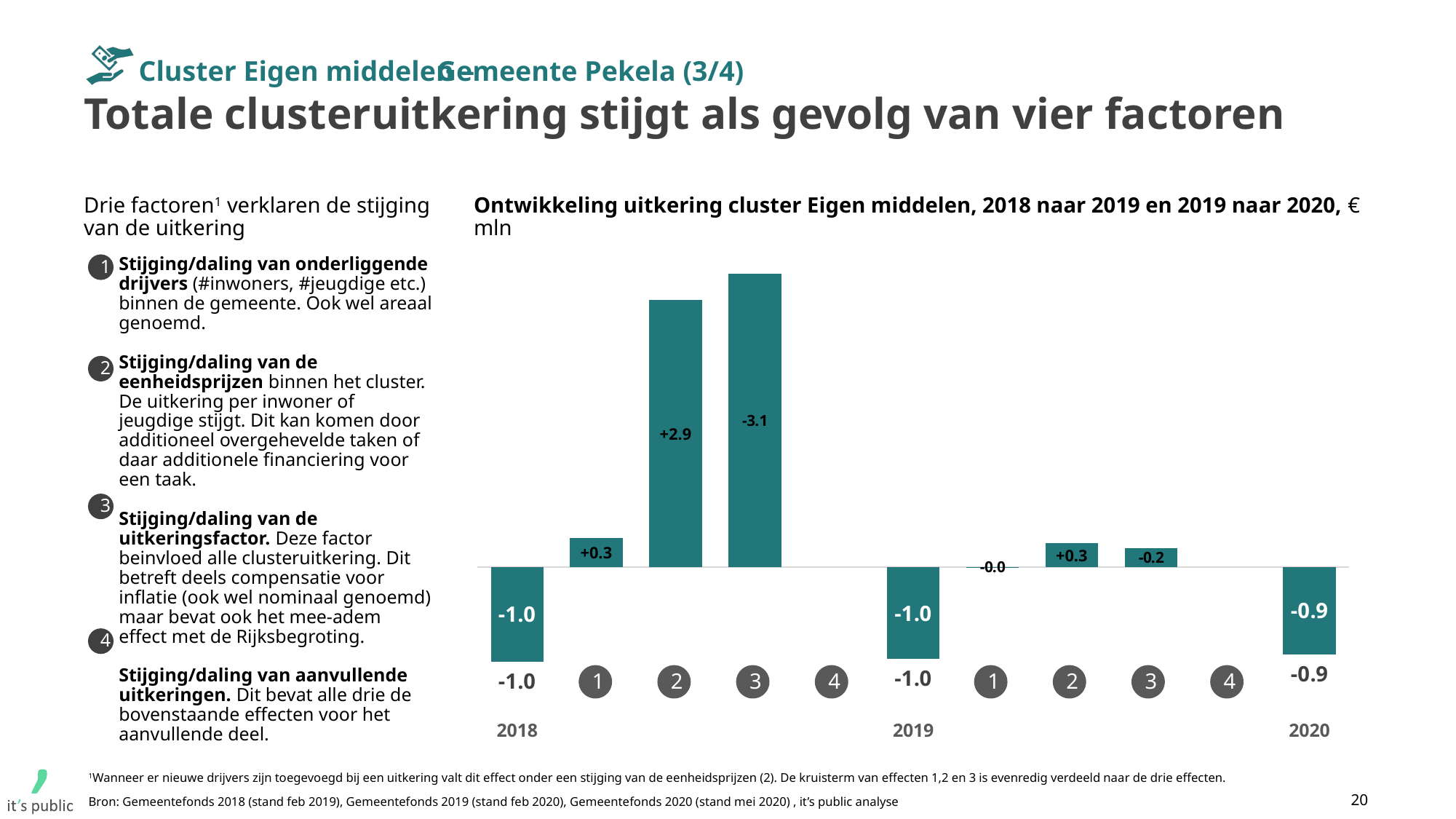
Which factor between 2018 and 2019 has the lowest (most negative) value? 3 What is the value labelled for factor 3 between 2018 and 2019? -3.1 Which factor between 2018 and 2019 has the tallest positive bar? 2 What unit is stated in the chart title? € mln What is the value labelled for factor 3 between 2019 and 2020? -0.2 What is the value of the 2020 bar in the chart? -0.9 What is the difference between the factor 2 value (+2.9) and the factor 3 value (-3.1) between 2018 and 2019? 6.0 What is the value of the 2018 bar in the chart 'Ontwikkeling uitkering cluster Eigen middelen'? -1.0 What type of chart is shown on the slide? bar chart Is the 2019 bar value larger or smaller than the 2020 bar value? smaller What is the value labelled for factor 1 between 2019 and 2020? -0.0 What is the value labelled for factor 2 between 2018 and 2019? +2.9